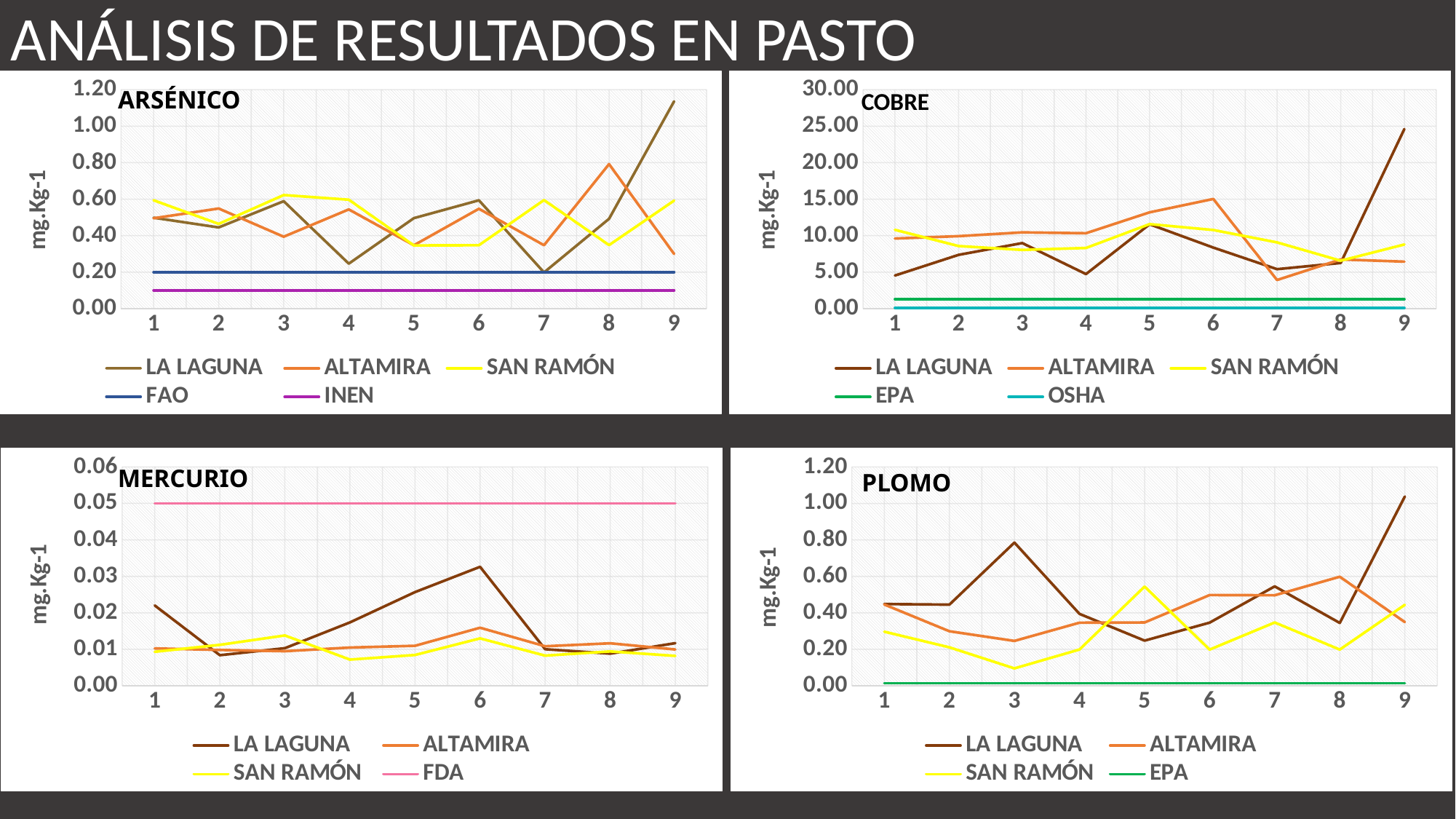
In the ARSÉNICO chart, is the value for LA LAGUNA at point 9 greater or less than 1.00? greater In the COBRE chart, is the value for LA LAGUNA at point 9 greater or less than 20.00? greater In the COBRE chart, is the value for ALTAMIRA at point 7 greater or less than 5.00? less What unit is shown on the y axis of the PLOMO chart? mg.Kg-1 How many points are plotted along the x axis of the COBRE chart? 9 In the PLOMO chart, which is larger at point 3, LA LAGUNA or ALTAMIRA? LA LAGUNA How many series does the legend of the MERCURIO chart list? 4 How many series does the legend of the ARSÉNICO chart list? 5 What kind of chart is the ARSÉNICO chart? line chart In the ARSÉNICO chart, which series has the highest value at point 9? LA LAGUNA In the MERCURIO chart, which series reaches the highest value at point 6? FDA